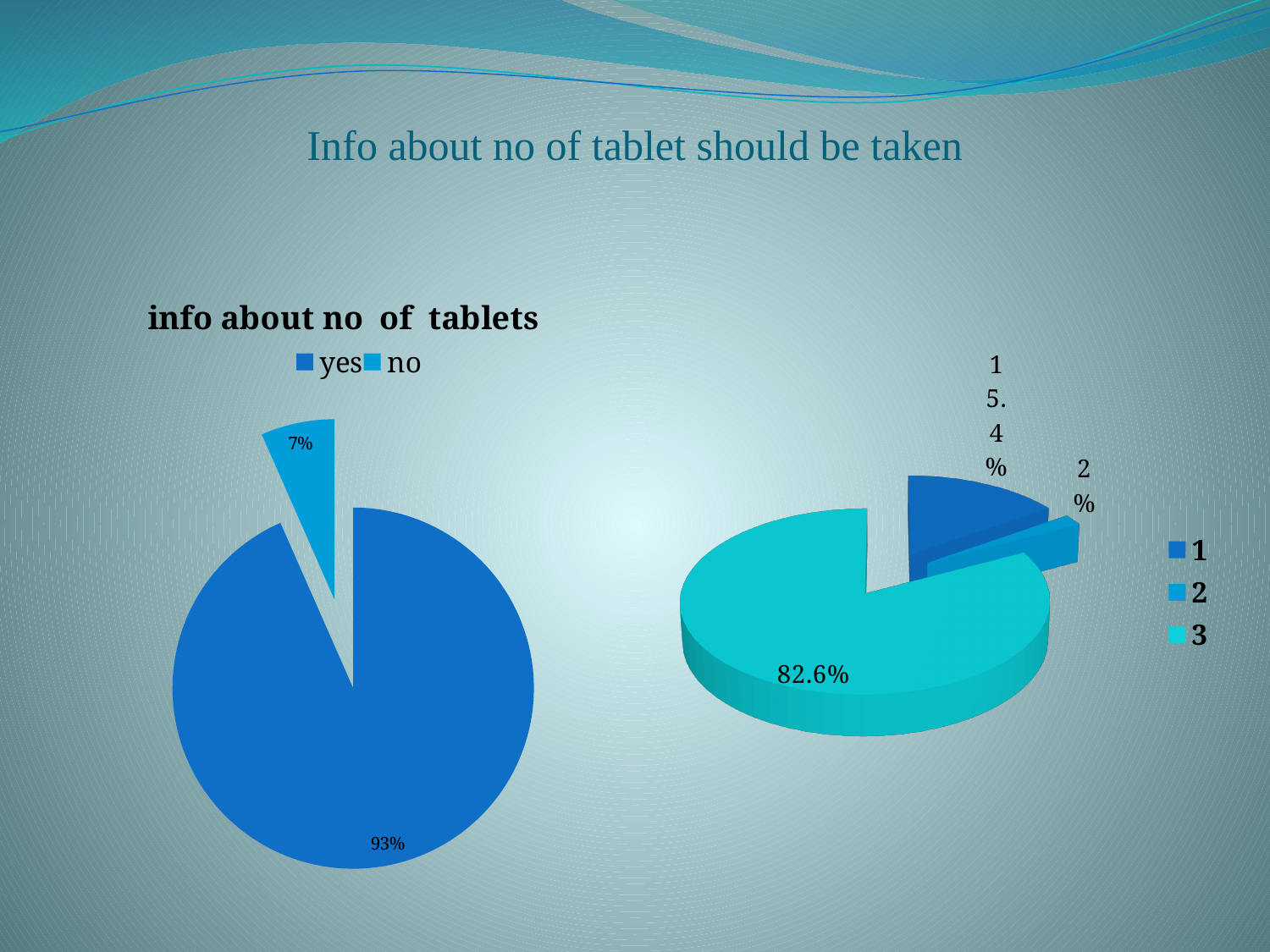
In the right pie chart, how many categories does the legend list? 3 In the left pie chart titled 'info about no of tablets', which category has the largest share? yes In the left pie chart titled 'info about no of tablets', what percentage is shown for 'no'? 7% In the left pie chart titled 'info about no of tablets', what is the difference in percentage points between 'yes' and 'no'? 86 What type of chart is the chart on the right side of the slide? pie chart In the left pie chart titled 'info about no of tablets', which category has the smallest share? no In the right pie chart, what percentage is shown for category '1'? 15.4% In the right pie chart, what percentage is shown for category '2'? 2% In the right pie chart, what percentage is shown for category '3'? 82.6% In the left pie chart titled 'info about no of tablets', what percentage is shown for 'yes'? 93% In the left pie chart titled 'info about no of tablets', how many categories does the legend list? 2 In the right pie chart, which category has the largest share? 3